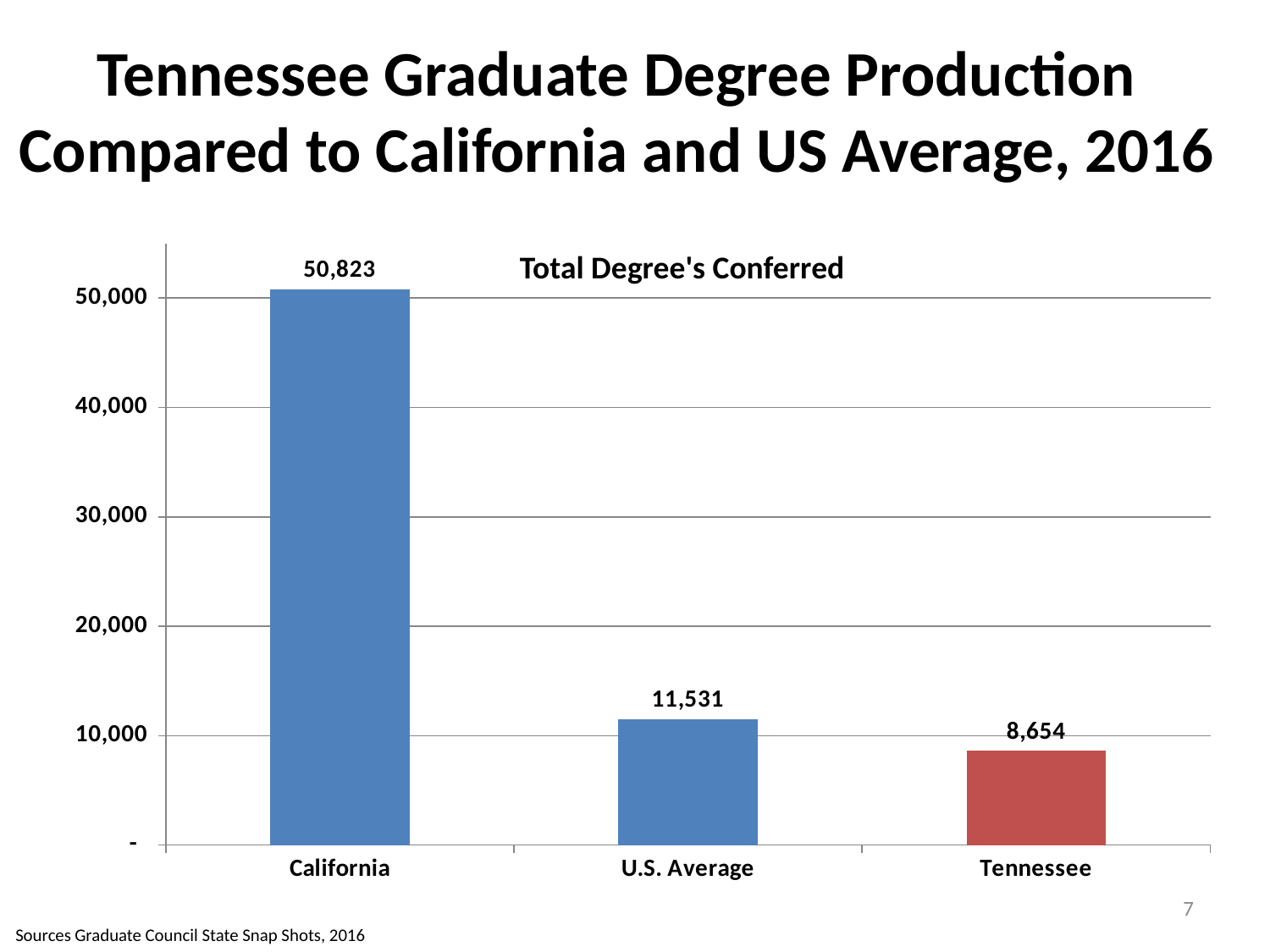
What is the title of the chart? Total Degree's Conferred What is the value for California? 50,823 What kind of chart is shown on the slide? bar chart Is the value for Tennessee greater or less than 10,000? less What is the difference between the values for U.S. Average and Tennessee? 2,877 Which category has the lowest value? Tennessee Which is larger, the value for U.S. Average or the value for Tennessee? U.S. Average What is the value for Tennessee? 8,654 Which category has the highest value? California What is the difference between the values for California and Tennessee? 42,169 How many categories are shown on the x axis? 3 What is the value for U.S. Average? 11,531